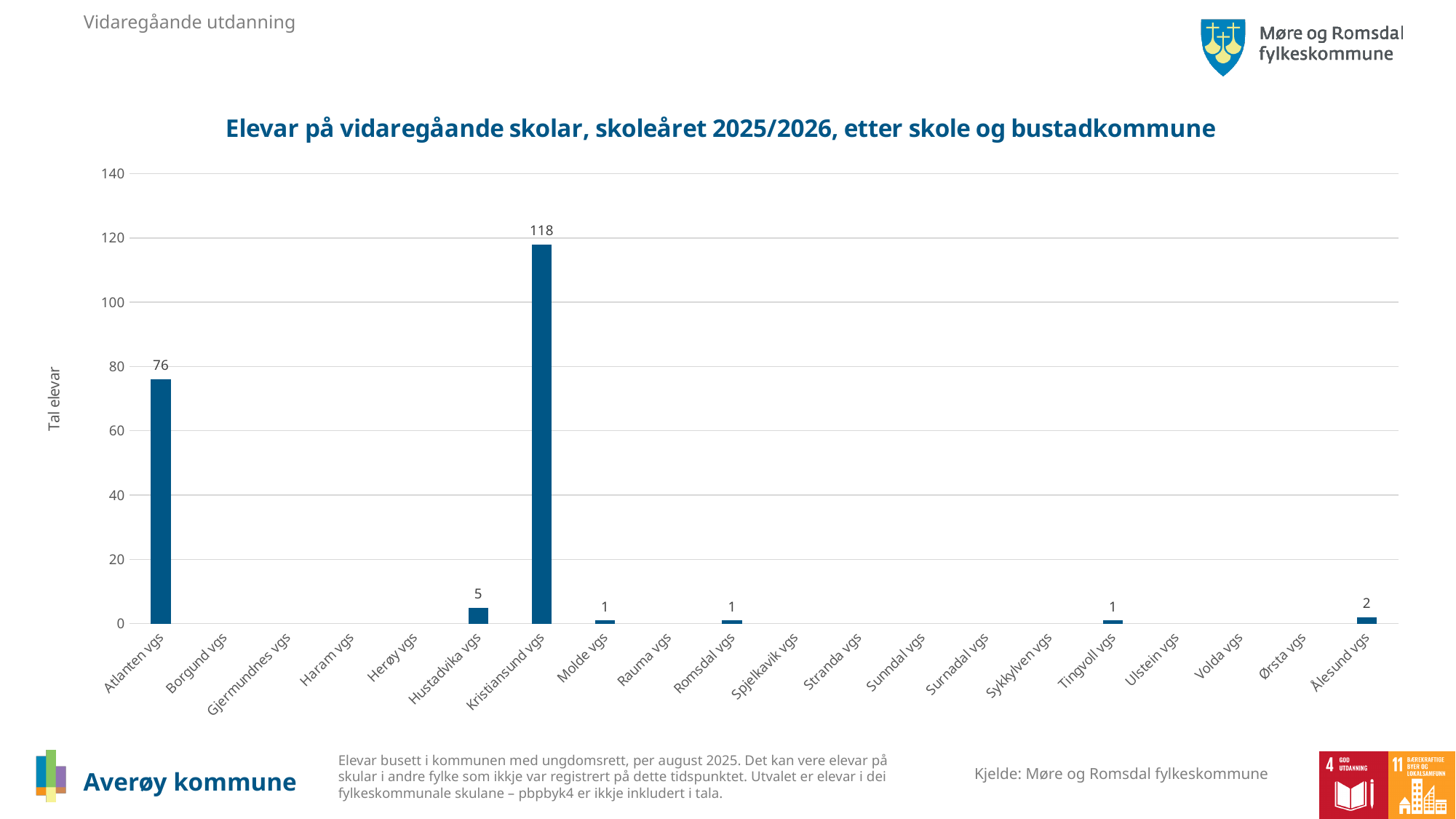
What is the label of the y axis? Tal elevar Which school has the highest number of pupils? Kristiansund vgs What is the value for Kristiansund vgs? 118 What is the value for Hustadvika vgs? 5 Is the value for Atlanten vgs greater or less than 80? less What kind of chart is shown on the slide? bar chart What is the value for Atlanten vgs? 76 What is the total of the values for Molde vgs, Romsdal vgs and Tingvoll vgs? 3 What is the difference between the values for Kristiansund vgs and Atlanten vgs? 42 Which is larger, the value for Hustadvika vgs or the value for Ålesund vgs? Hustadvika vgs How many schools are listed on the x axis? 20 What is the value for Ålesund vgs? 2